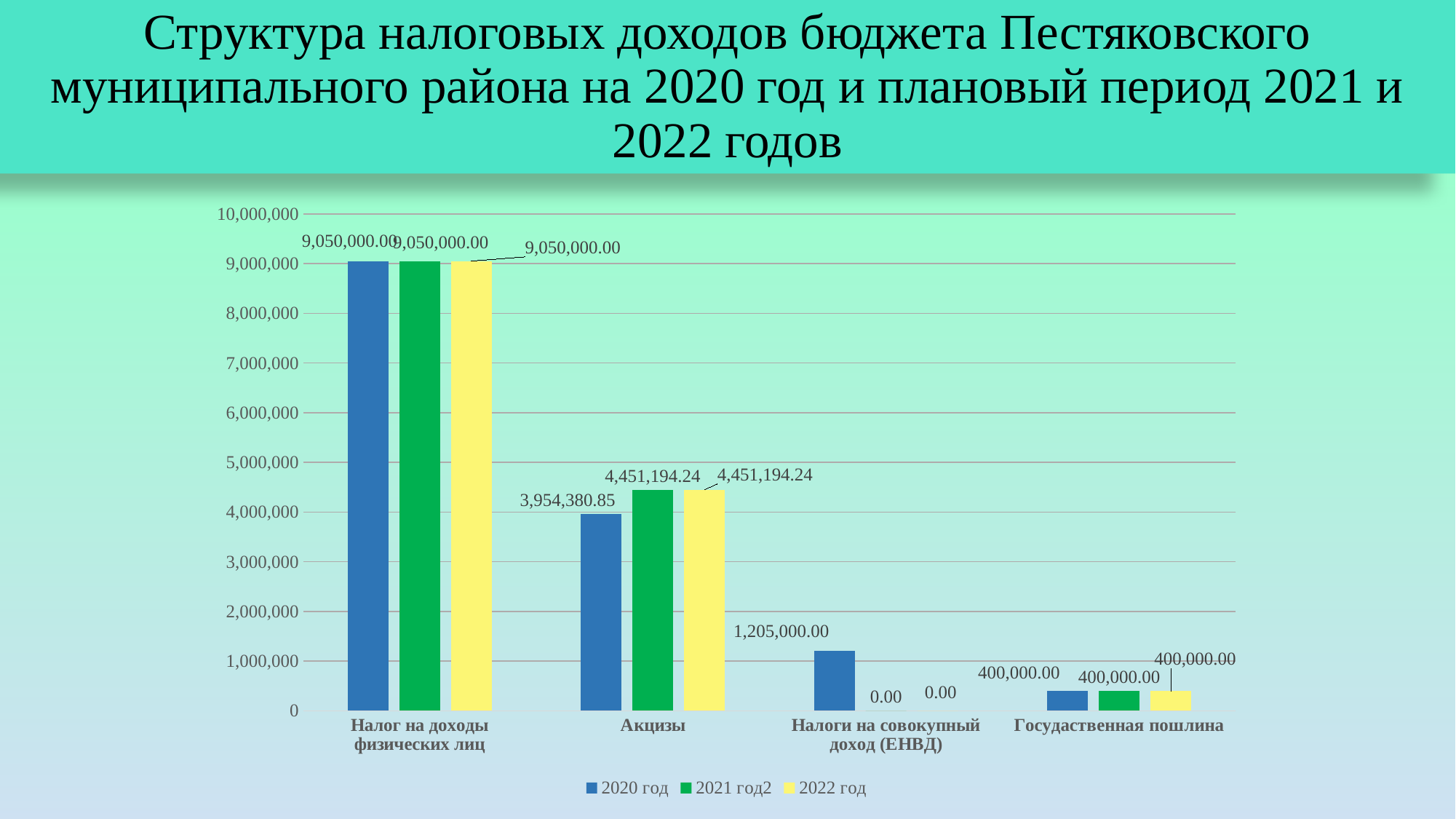
What is the value for Акцизы in the 2020 год series? 3,954,380.85 Which is larger for Акцизы: the 2020 год value or the 2022 год value? 2022 год How many categories are shown on the x axis? 4 What is the difference between the 2021 год2 and 2020 год values for Акцизы? 496,813.39 What is the value for Налог на доходы физических лиц in the 2021 год2 series? 9,050,000.00 What is the value for Налоги на совокупный доход (ЕНВД) in the 2020 год series? 1,205,000.00 How many series does the legend list? 3 Is the 2020 год value for Налоги на совокупный доход (ЕНВД) greater or less than 1,000,000? greater Which category has the lowest value in the 2022 год series? Налоги на совокупный доход (ЕНВД) What is the value for Государственная пошлина in the 2022 год series? 400,000.00 Which category has the highest value in the 2020 год series? Налог на доходы физических лиц What kind of chart is shown on the slide? bar chart